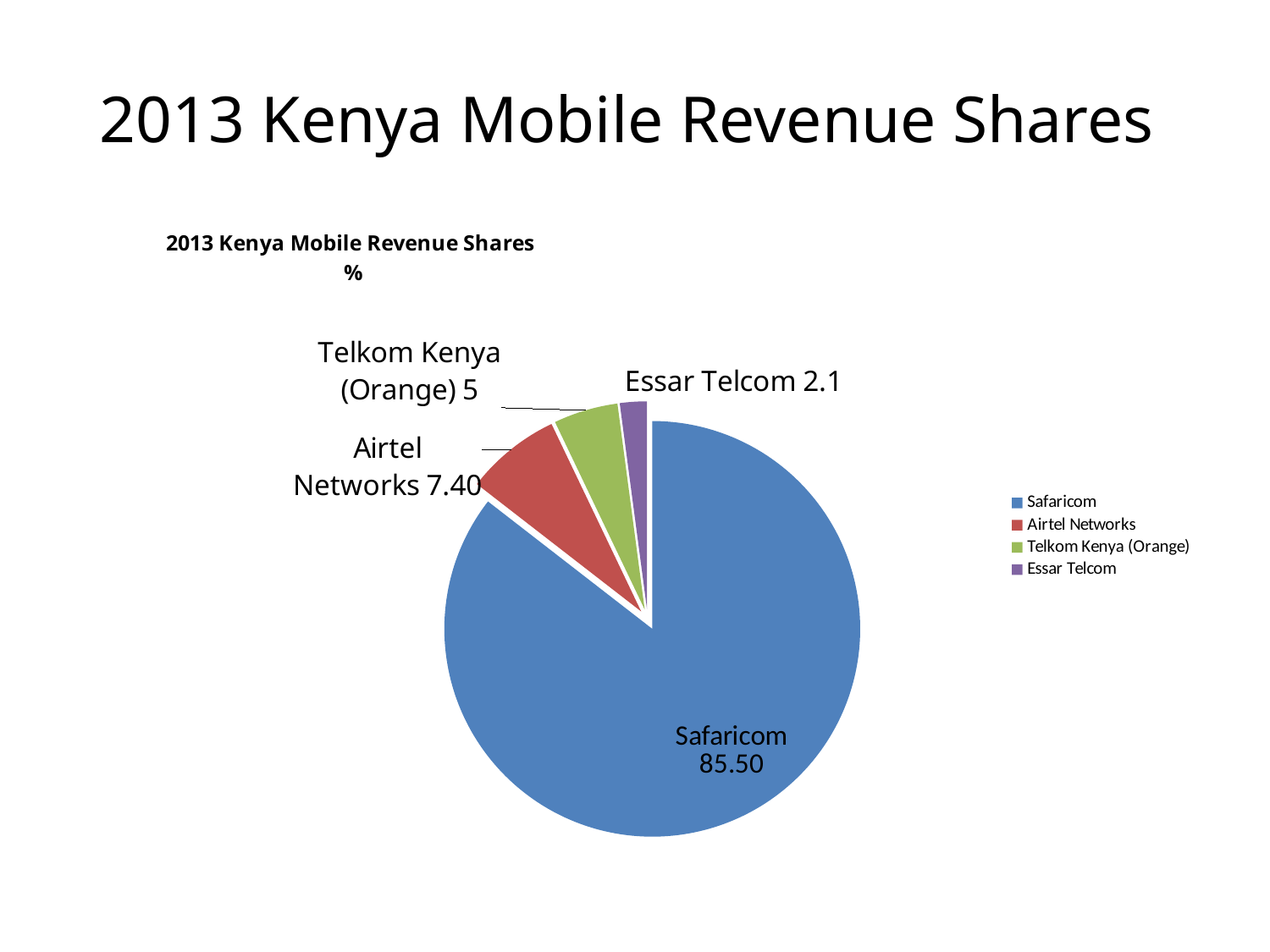
Which company has the smallest slice of the pie? Essar Telcom What is the difference between the values for Safaricom and Airtel Networks? 78.10 What kind of chart is shown on the slide? pie chart What is the value shown for Safaricom? 85.50 What is the value shown for Essar Telcom? 2.1 What is the value shown for Telkom Kenya (Orange)? 5 Which company has the largest slice of the pie? Safaricom What is the value shown for Airtel Networks? 7.40 How many entries does the legend list? 4 Which is larger, the value for Airtel Networks or the value for Telkom Kenya (Orange)? Airtel Networks What colour is the Safaricom slice? blue How many slices does the pie chart have? 4